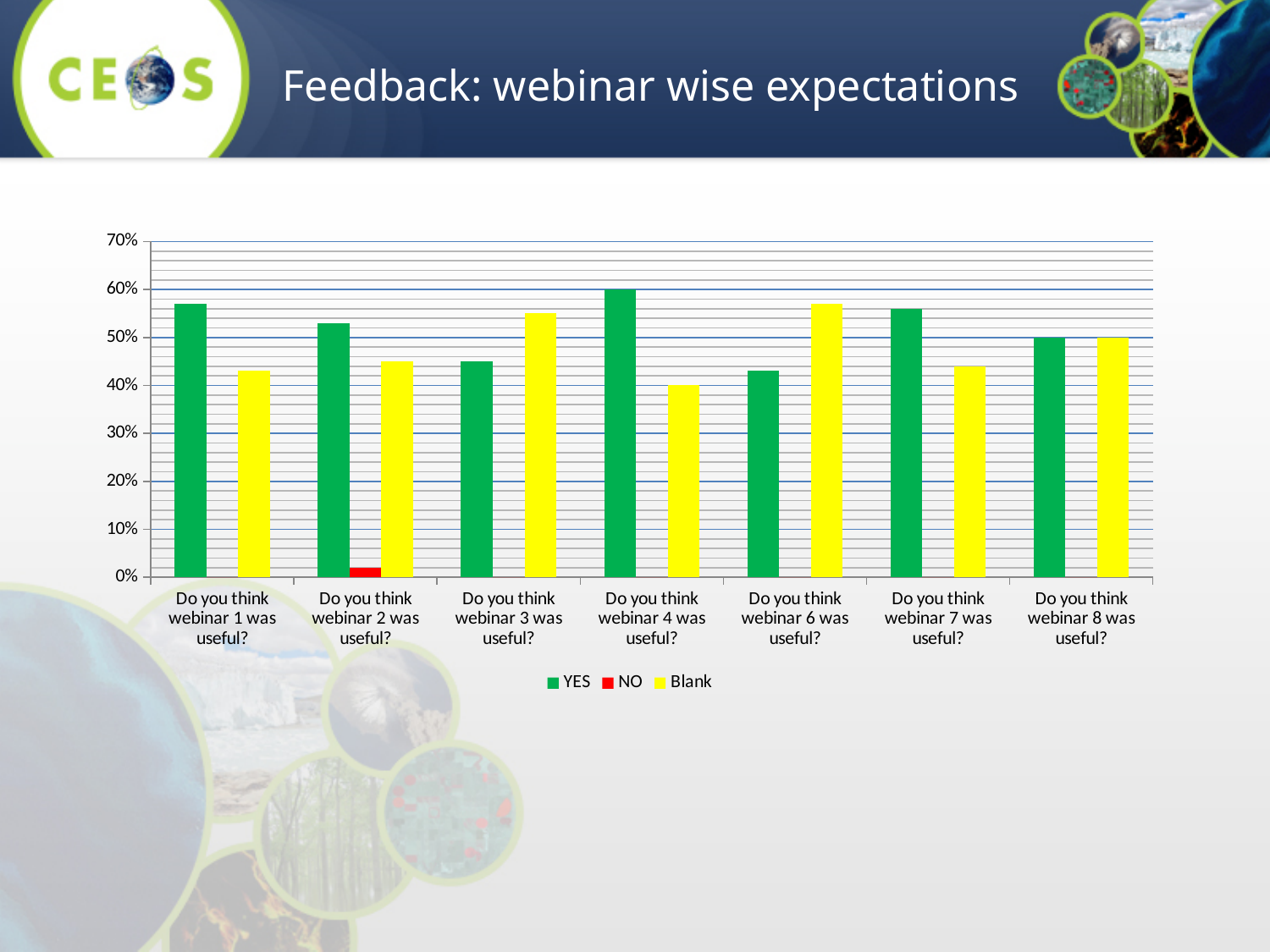
Is the Blank value for 'Do you think webinar 4 was useful?' greater or less than 50%? less For 'Do you think webinar 3 was useful?', which is larger, YES or Blank? Blank For 'Do you think webinar 1 was useful?', which is larger, YES or Blank? YES What is the YES value for 'Do you think webinar 4 was useful?' 60% Which webinar is the only one with a visible NO bar? Do you think webinar 2 was useful? What kind of chart is shown on the slide? bar chart Is the NO value for 'Do you think webinar 2 was useful?' greater or less than 10%? less Is the YES value for 'Do you think webinar 1 was useful?' greater or less than 50%? greater How many series does the legend list? 3 For which webinar is the YES value highest? Do you think webinar 4 was useful? What colour represents the NO series in the legend? red How many webinar questions (categories) are shown on the x axis? 7